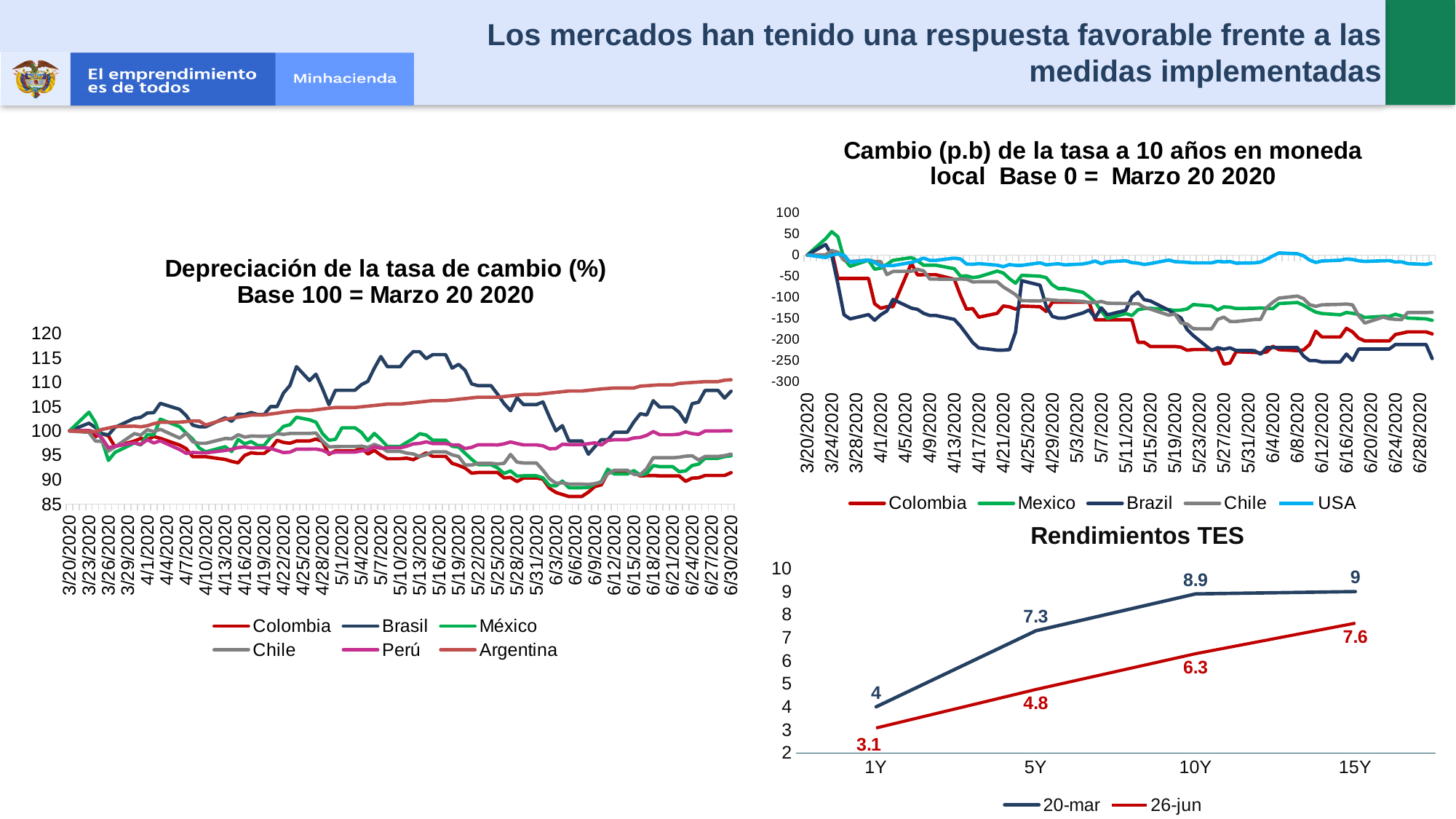
In the Rendimientos TES chart, at which maturity is the 20-mar series lowest? 1Y In the Rendimientos TES chart, at which maturity is the 26-jun series highest? 15Y In the 'Cambio (p.b) de la tasa a 10 años en moneda local' chart, is the value for Colombia at 6/28/2020 greater or less than -150? less How many series does the legend of the Rendimientos TES chart list? 2 In the Rendimientos TES chart, what is the value of the 20-mar series at 10Y? 8.9 In the Rendimientos TES chart, which is larger: the 20-mar value at 5Y or the 26-jun value at 10Y? 20-mar at 5Y In the Rendimientos TES chart, do the 26-jun values rise or fall from 1Y to 15Y? rise In the Rendimientos TES chart, what is the difference between the 20-mar and 26-jun values at 15Y? 1.4 How many maturity categories are shown on the x axis of the Rendimientos TES chart? 4 In the Rendimientos TES chart, what is the value of the 26-jun series at 1Y? 3.1 How many series does the legend of the 'Depreciación de la tasa de cambio (%)' chart list? 6 What kind of chart is the 'Cambio (p.b) de la tasa a 10 años en moneda local' chart? line chart